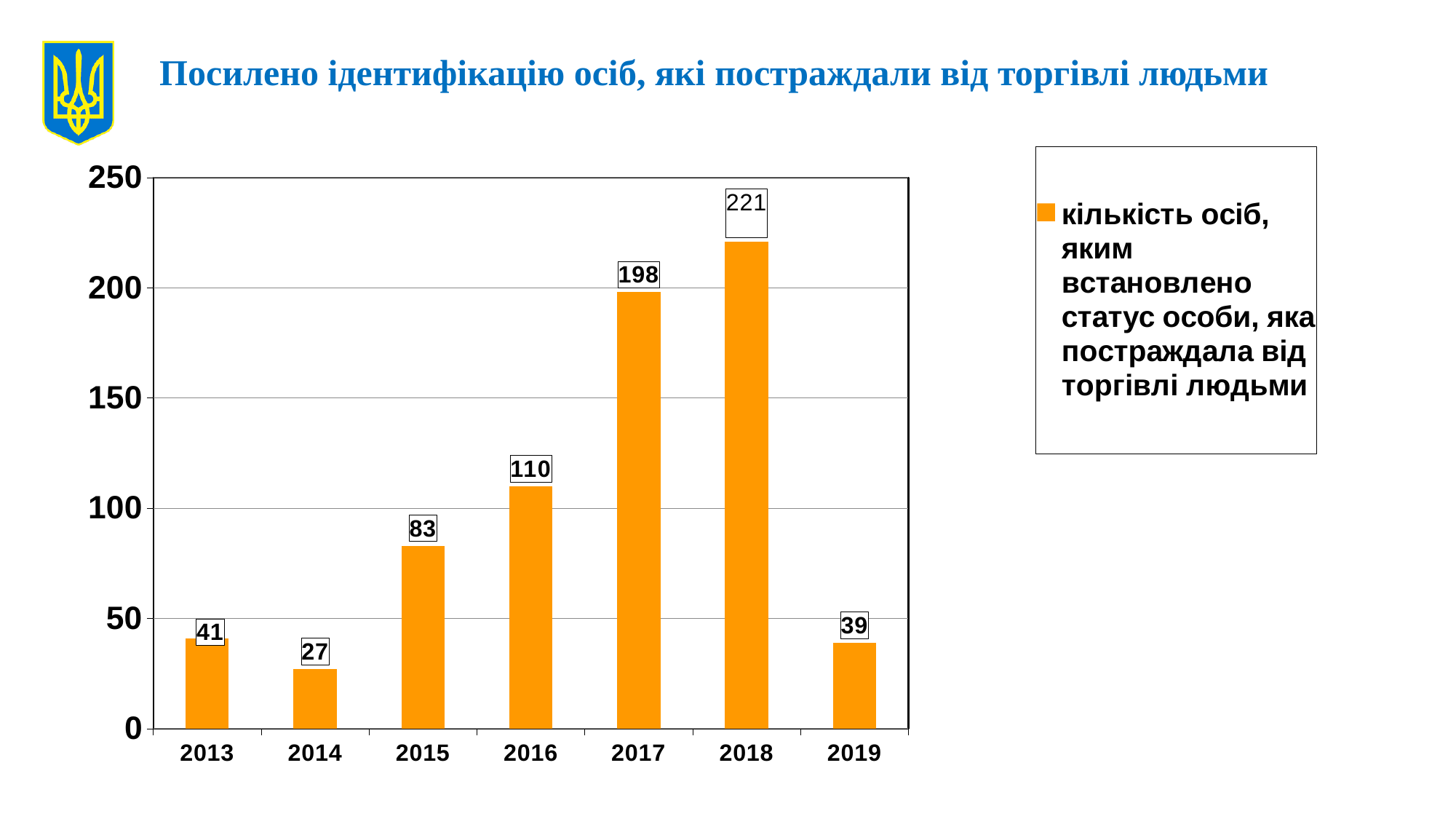
Is the value for 2017 greater or less than 150? greater Do the values rise or fall from 2013 to 2018? rise What is the value for 2018? 221 What is the difference between the values for 2018 and 2017? 23 Which year has the lowest value? 2014 What kind of chart is shown on the slide? bar chart What is the value for 2019? 39 How many years are shown on the x axis? 7 What is the value for 2015? 83 What is the difference between the values for 2016 and 2015? 27 Which year has the highest value? 2018 Which is larger, the value for 2013 or the value for 2019? 2013